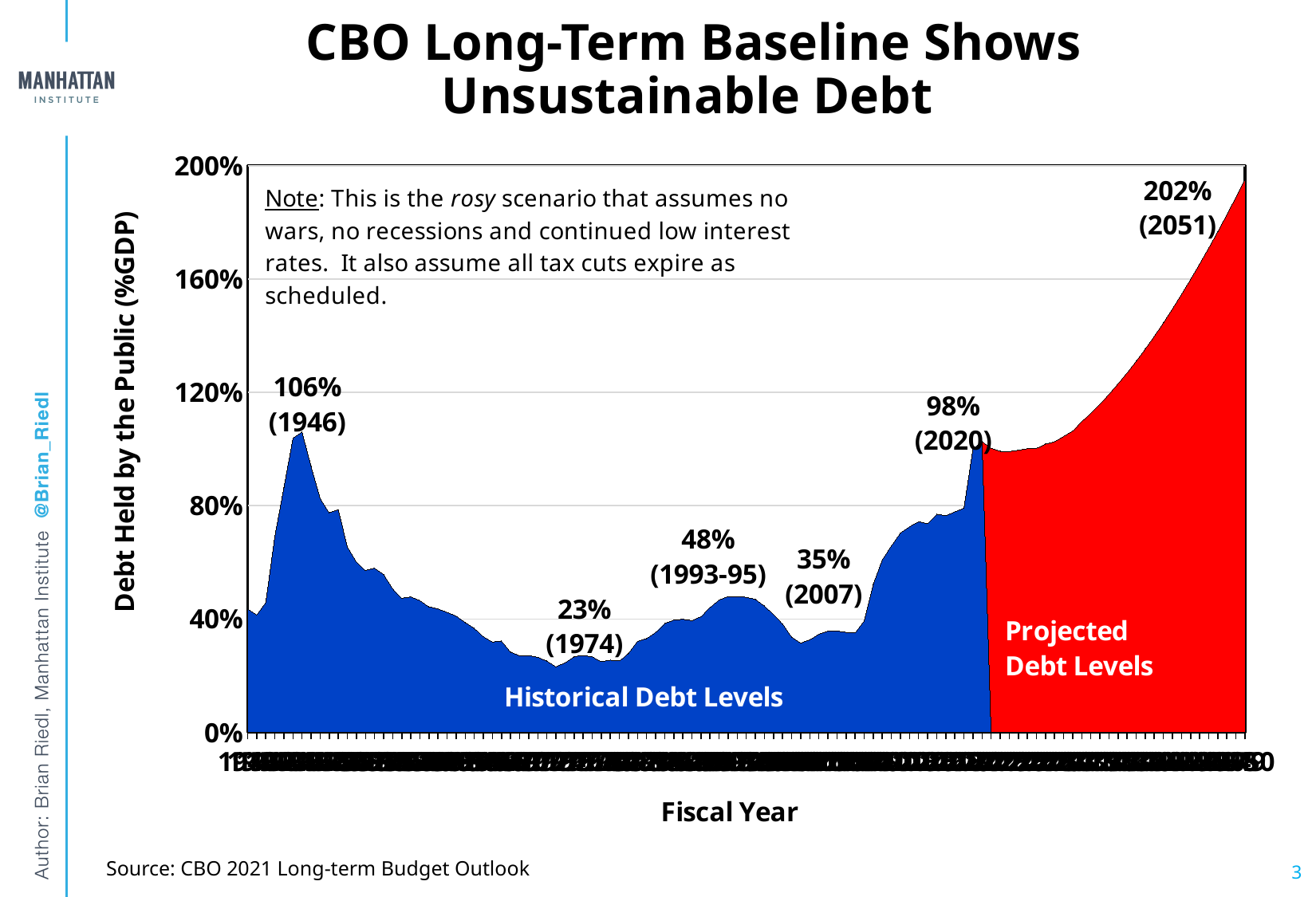
What debt level is labeled for 2020 on the chart? 98% What colour is used for the projected debt levels on the chart? Red Which labeled year has the highest debt level on the chart? 2051 What is the debt held by the public as a percentage of GDP in 1946, according to the chart's label? 106% Which labeled year has the lowest debt level on the chart? 1974 Is the labeled debt level for 1993-95 greater or less than 40%? greater What kind of chart is shown on the slide? Area chart What debt level is labeled for 2007? 35% Which is larger, the labeled debt level for 1946 or for 2020? 1946 What debt level does the chart label for 1974? 23% How many percentage points higher is the labeled 2051 debt level than the labeled 2020 level? 104 percentage points What projected debt level is labeled for 2051? 202%